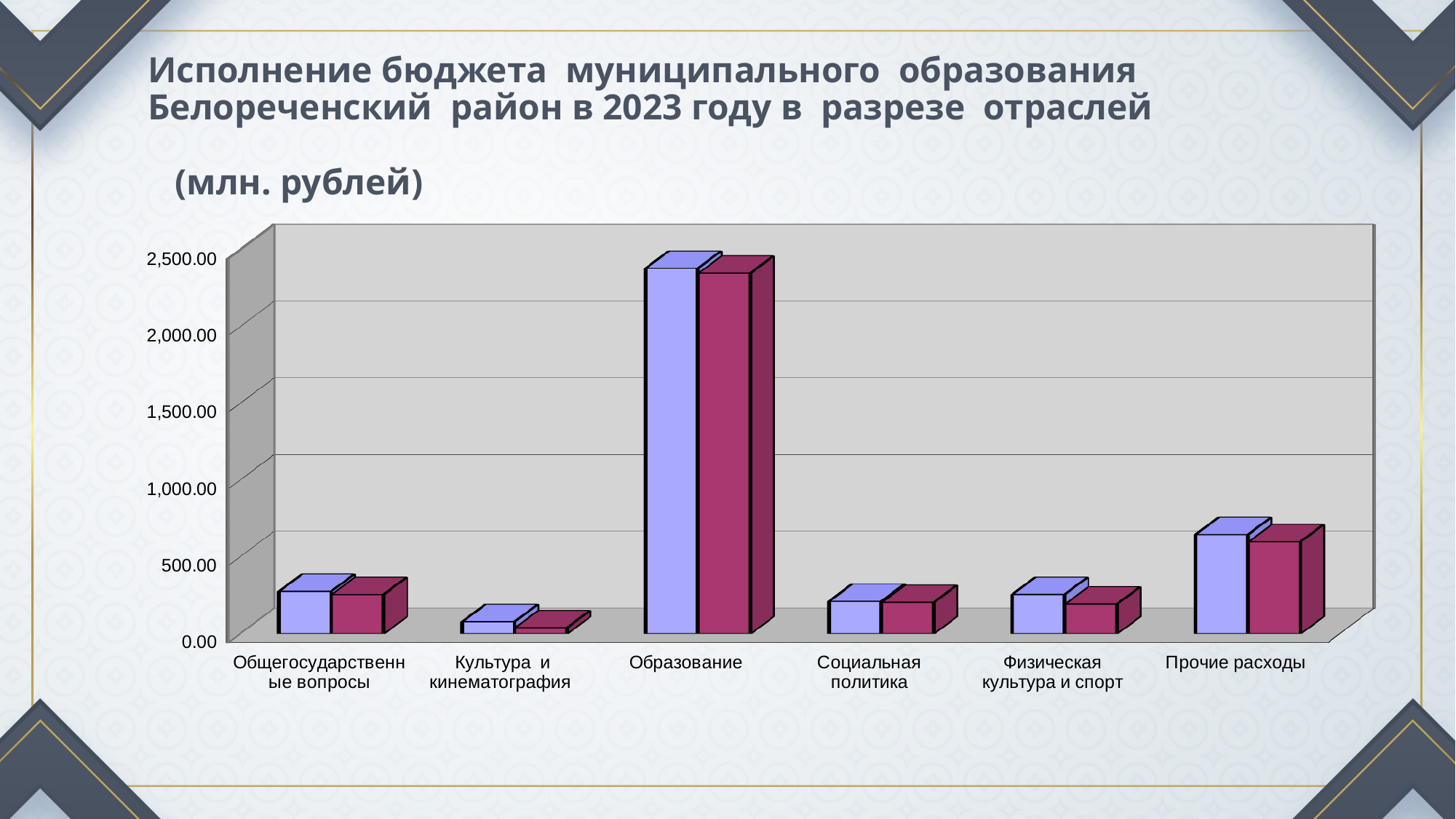
Which is larger, the value for Образование or the value for Прочие расходы? Образование Which category has the highest bars in the chart? Образование Is the value for Прочие расходы greater or less than 500.00? greater What kind of chart is shown on the slide? bar chart Is the value for Культура и кинематография greater or less than 500.00? less Is the value for Образование greater or less than 2,000.00? greater In what units are the values on the chart expressed, according to the slide? млн. рублей How many categories are shown on the x axis of the chart? 6 What is the highest tick value shown on the vertical axis of the chart? 2,500.00 Which is larger, the value for Прочие расходы or the value for Социальная политика? Прочие расходы Which category has the lowest bars in the chart? Культура и кинематография